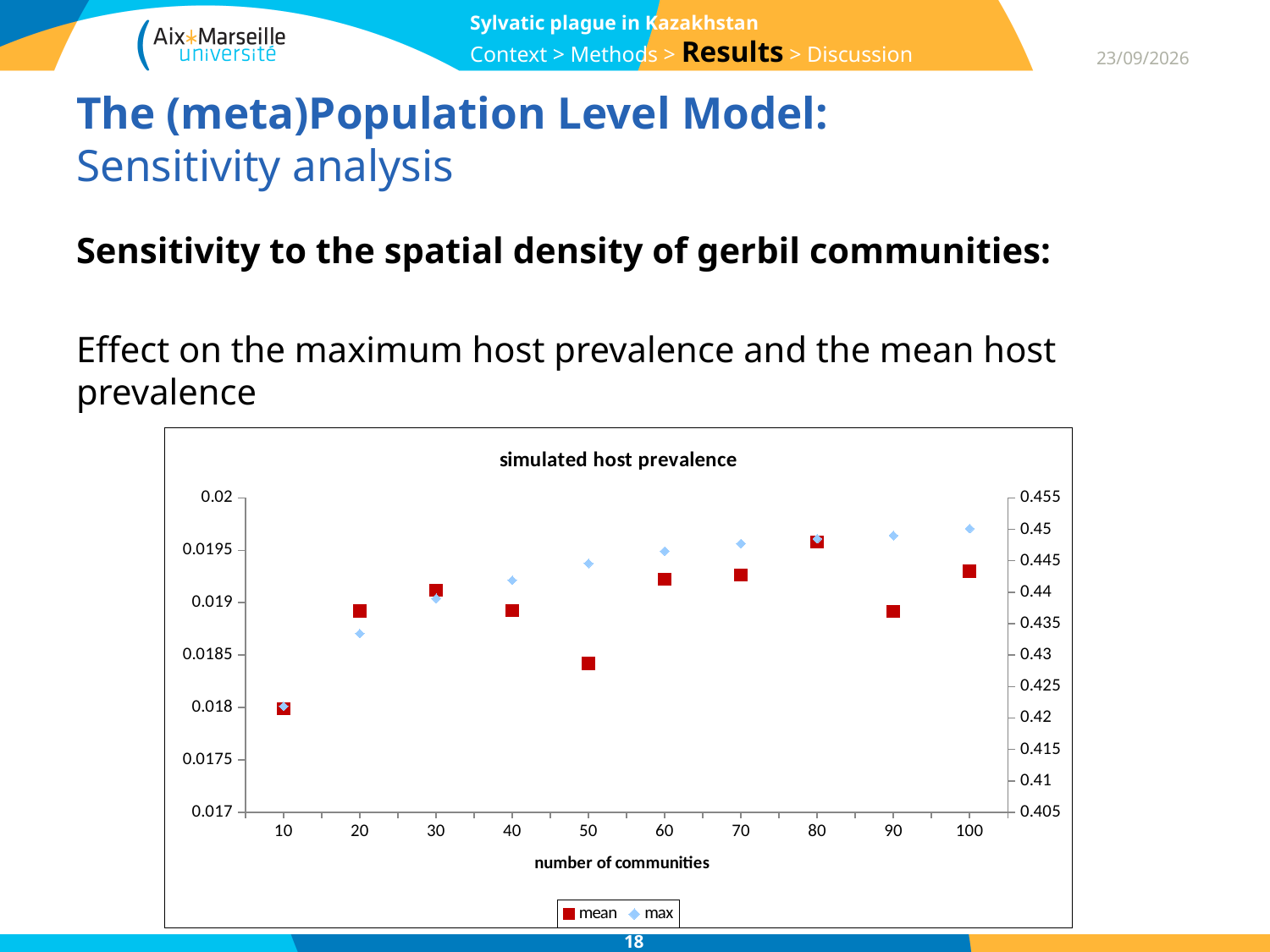
At which number of communities is the max series lowest? 10 What kind of chart is shown on the slide? scatter chart Is the mean value at 80 communities greater or less than 0.0195? greater What is the label of the x axis? number of communities Is the max value at 10 communities greater or less than 0.425? less How many series does the chart legend list? 2 Is the mean value at 50 communities greater or less than 0.019? less At which number of communities is the mean series highest? 80 What is the title of the chart? simulated host prevalence How many values of number of communities are plotted on the x axis? 10 Which is larger, the mean value at 30 communities or at 50 communities? 30 communities At which number of communities is the mean series lowest? 10